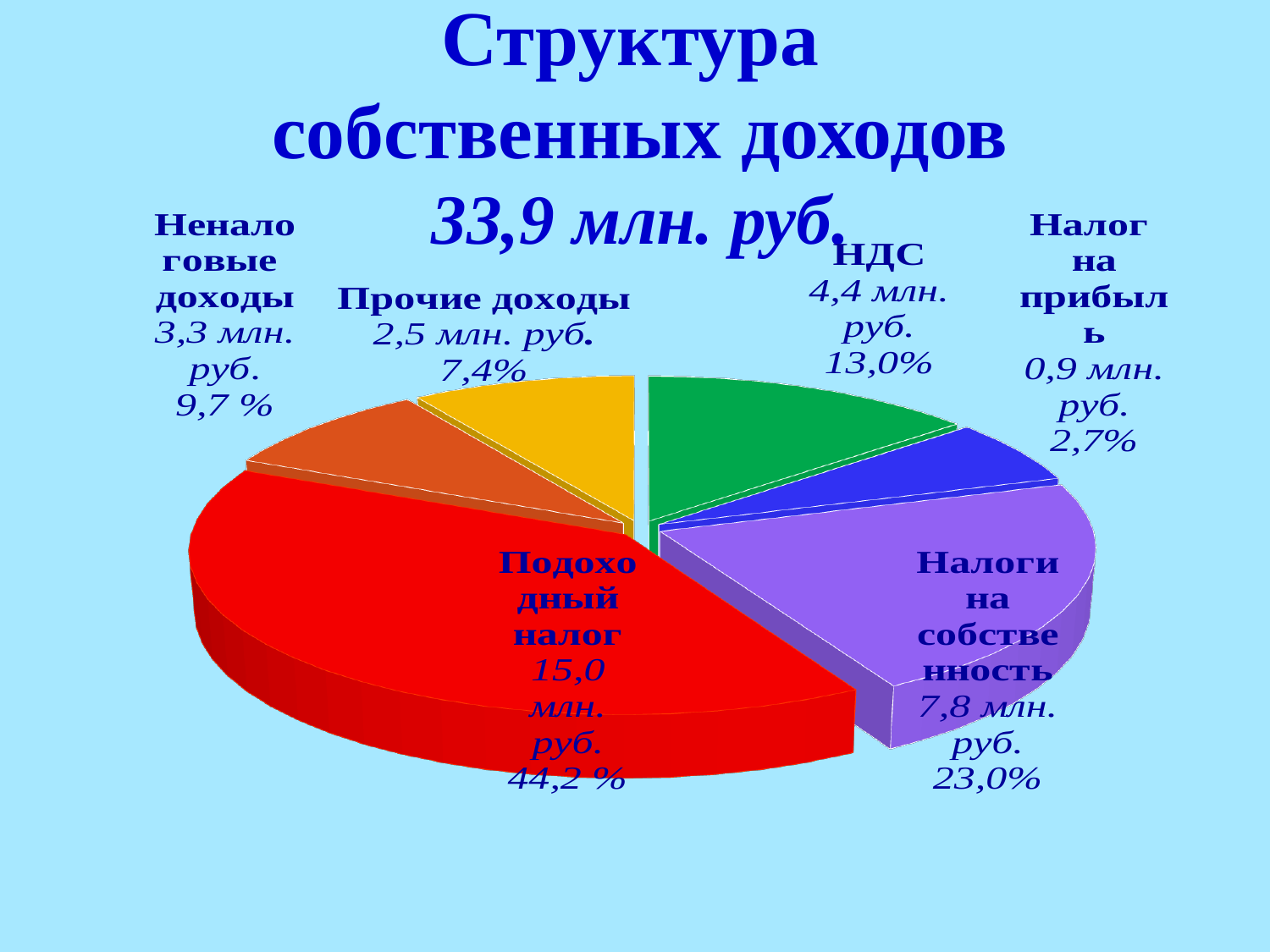
How many slices does the pie chart have? 6 Which category has the largest share of the pie? Подоходный налог What is the value for Прочие доходы in млн. руб.? 2,5 млн. руб. What share of own revenues does Подоходный налог account for? 44,2 % What is the value for НДС in млн. руб.? 4,4 млн. руб. What is the difference in млн. руб. between Подоходный налог and Налоги на собственность? 7,2 млн. руб. What is the value for Налоги на собственность in млн. руб.? 7,8 млн. руб. What kind of chart is shown on the slide? Pie chart Which is larger, Неналоговые доходы or Прочие доходы? Неналоговые доходы Which category has the smallest share of the pie? Налог на прибыль What total amount of own revenues is stated in the chart title? 33,9 млн. руб. What percentage share does Налог на прибыль have? 2,7%